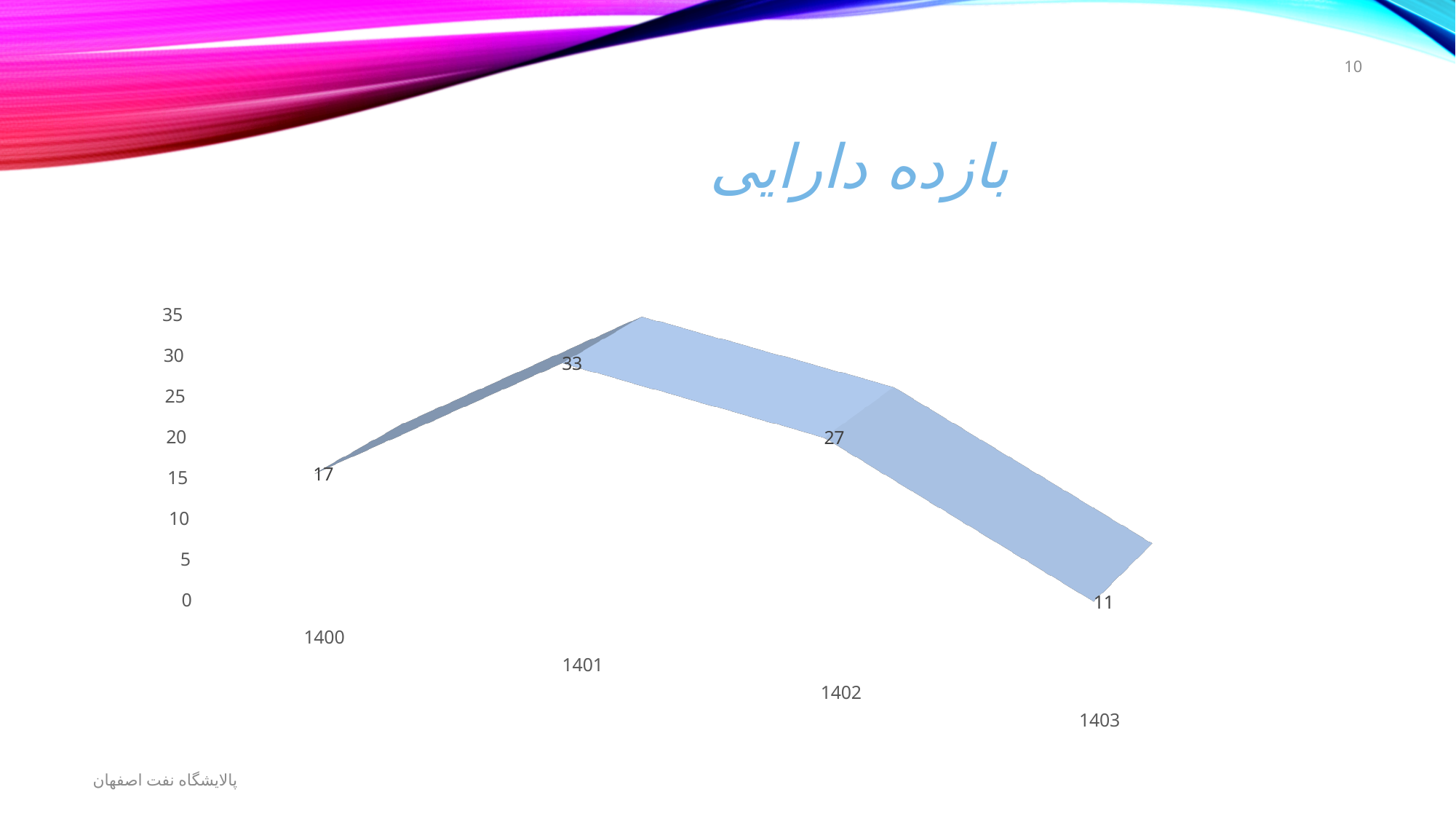
Which year has the lowest value? 1403 What is the value for 1402? 27 What is the value for 1401? 33 What is the title of the chart on the slide? بازده دارایی Which year has the highest value? 1401 How many years are plotted on the x axis? 4 What is the difference between the values for 1400 and 1403? 6 Does the value rise or fall from 1401 to 1403? fall What is the value for 1400? 17 Which is larger, the value for 1400 or the value for 1402? 1402 What is the difference between the values for 1401 and 1402? 6 What is the value for 1403? 11